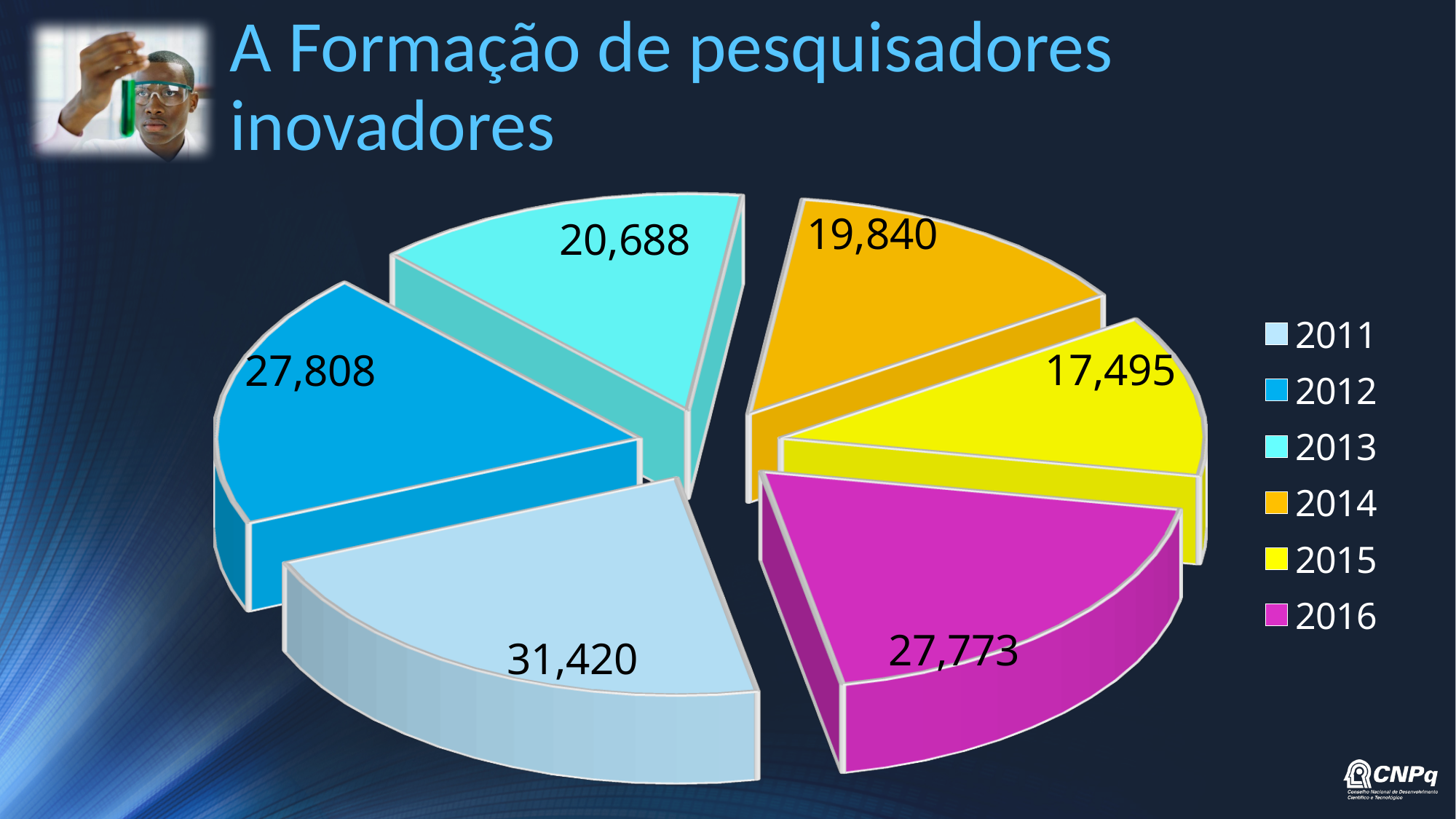
What is the value for 2015? 17,495 What is the difference between the values for 2011 and 2015? 13,925 What type of chart is shown on the slide? Pie chart What is the value for 2011? 31,420 What is the value for 2016? 27,773 What is the value for 2014? 19,840 Which is larger, the value for 2012 or the value for 2016? 2012 Which year has the largest slice? 2011 How many years does the legend list? 6 What is the difference between the values for 2012 and 2013? 7,120 Which year has the smallest slice? 2015 What colour is the slice for 2014? Orange